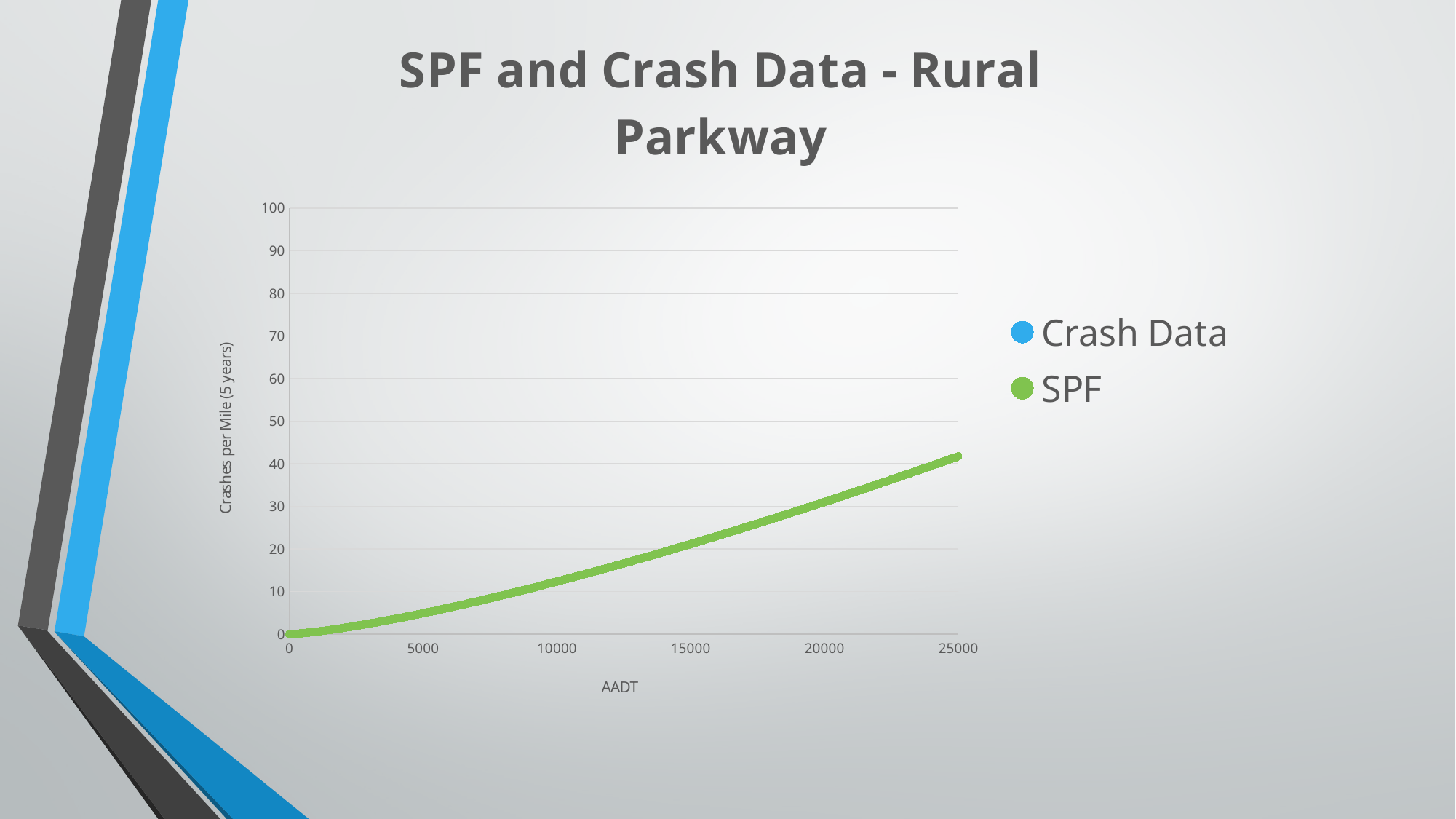
Is the SPF value at an AADT of 20000 greater or less than 20? greater How many series does the legend list? 2 Is the SPF value at an AADT of 25000 greater or less than 30? greater What is the label on the vertical axis? Crashes per Mile (5 years) At which AADT value is the SPF line at its lowest? 0 At which AADT value does the SPF line reach its highest point? 25000 What kind of chart is shown on the slide? line chart What is the title of the chart? SPF and Crash Data - Rural Parkway Is the SPF value at an AADT of 5000 greater or less than 10? less Does the SPF line rise or fall as AADT increases? rises